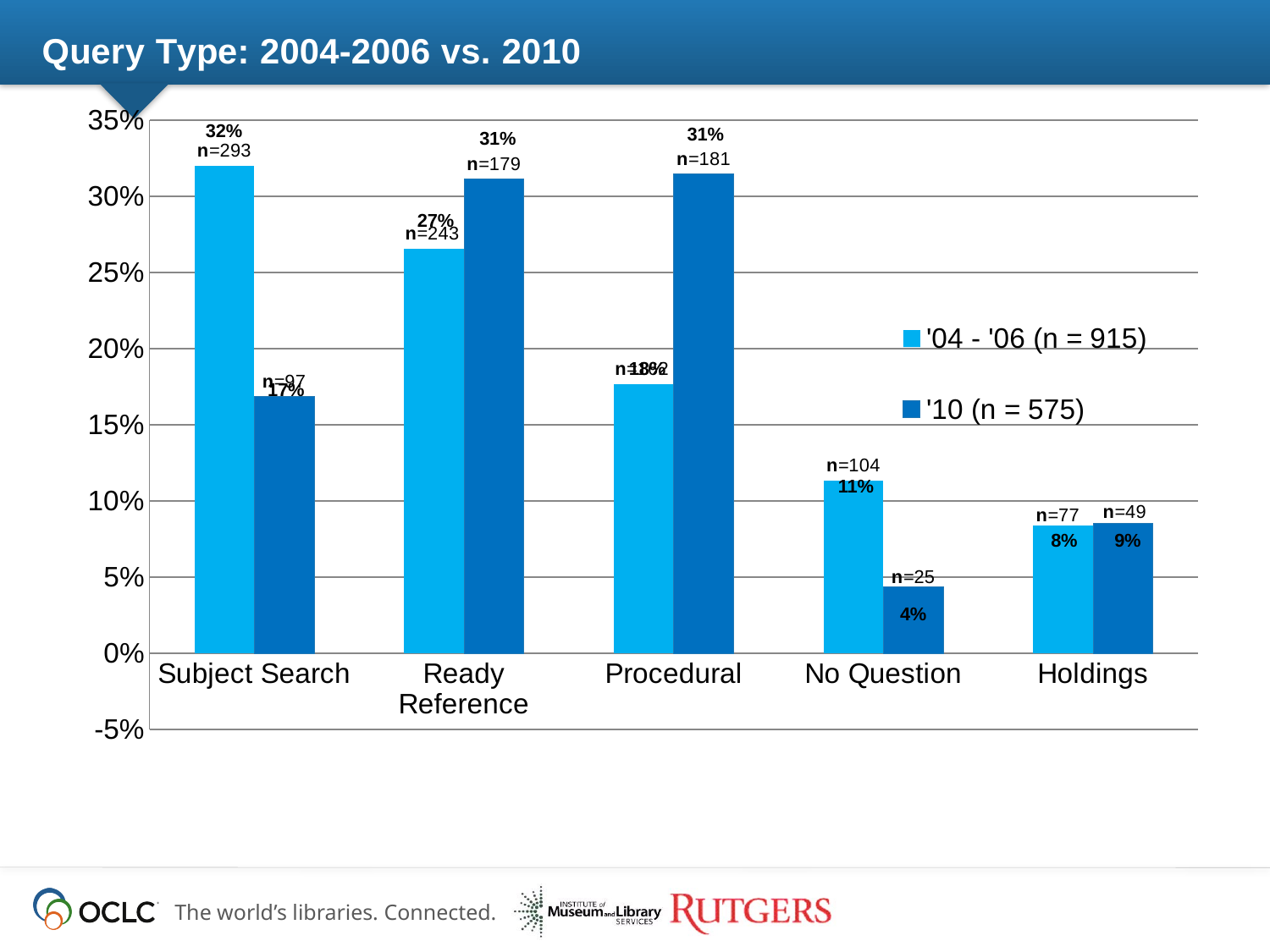
What is the value for Holdings in the '04 - '06 series? 8% Which category has the highest value in the '04 - '06 series? Subject Search What kind of chart is shown on the slide? bar chart What is the difference between the '04 - '06 and '10 values for No Question? 7% What is the value for Procedural in the '10 series? 31% Which category has the lowest value in the '10 series? No Question Is the value for Procedural in the '04 - '06 series greater or less than 20%? less What is the value for No Question in the '10 series? 4% Which is larger for Ready Reference: the '04 - '06 value or the '10 value? '10 How many query type categories are shown on the x axis? 5 How many series does the legend list? 2 What is the value for Subject Search in the '04 - '06 series? 32%